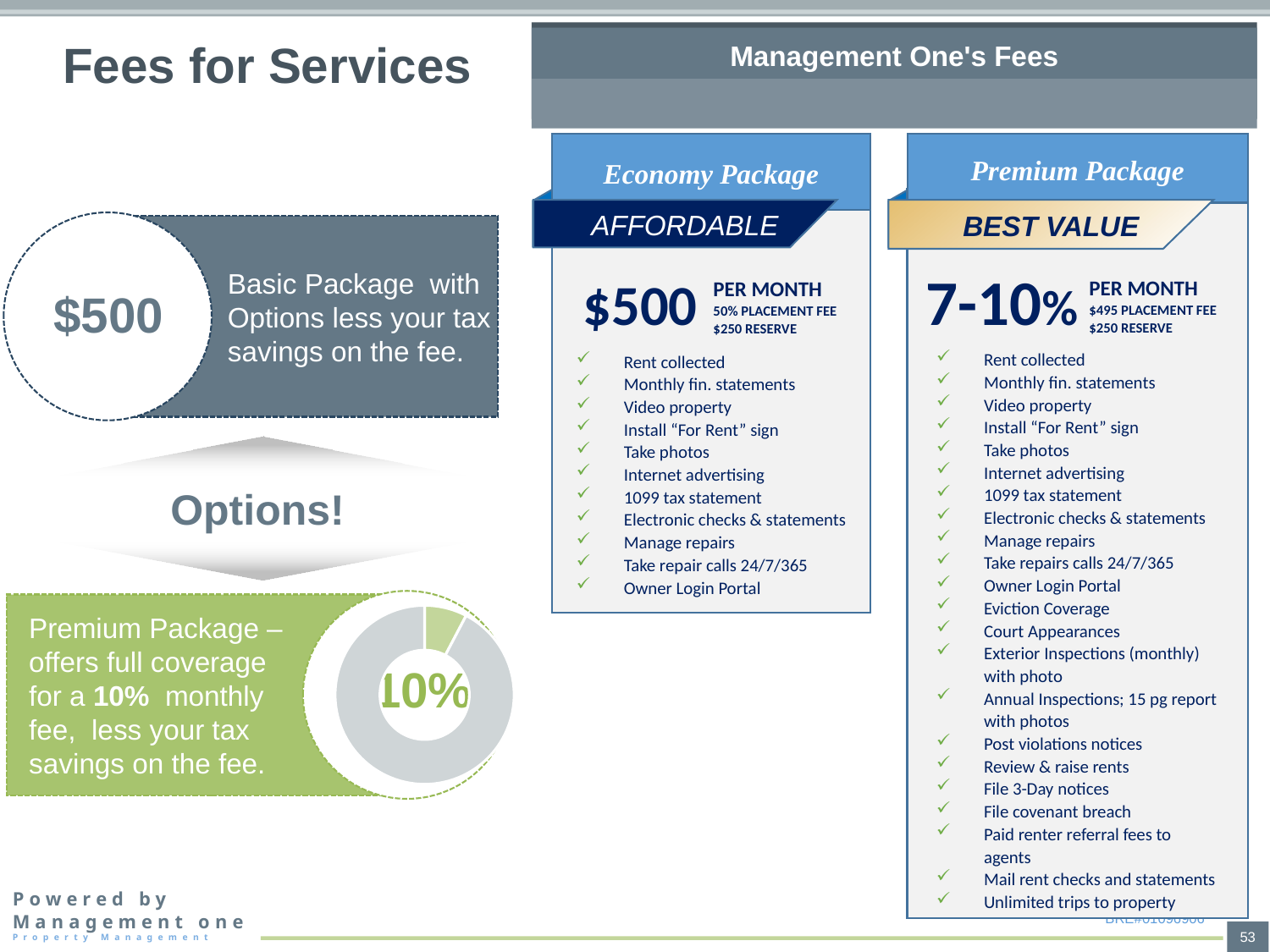
In the doughnut chart, which slice is larger, the green slice or the grey slice? The grey slice Which package does the doughnut chart's 10% monthly fee refer to? Premium Package What share of the doughnut chart does the small green slice represent? 10% What kind of chart is shown in the lower-left of the slide next to the Premium Package text? Doughnut chart What value is printed in the centre of the doughnut chart? 10% What colour is the small slice in the doughnut chart? Green How many slices does the doughnut chart have? 2 Is the share shown by the green slice of the doughnut chart greater or less than 50%? less